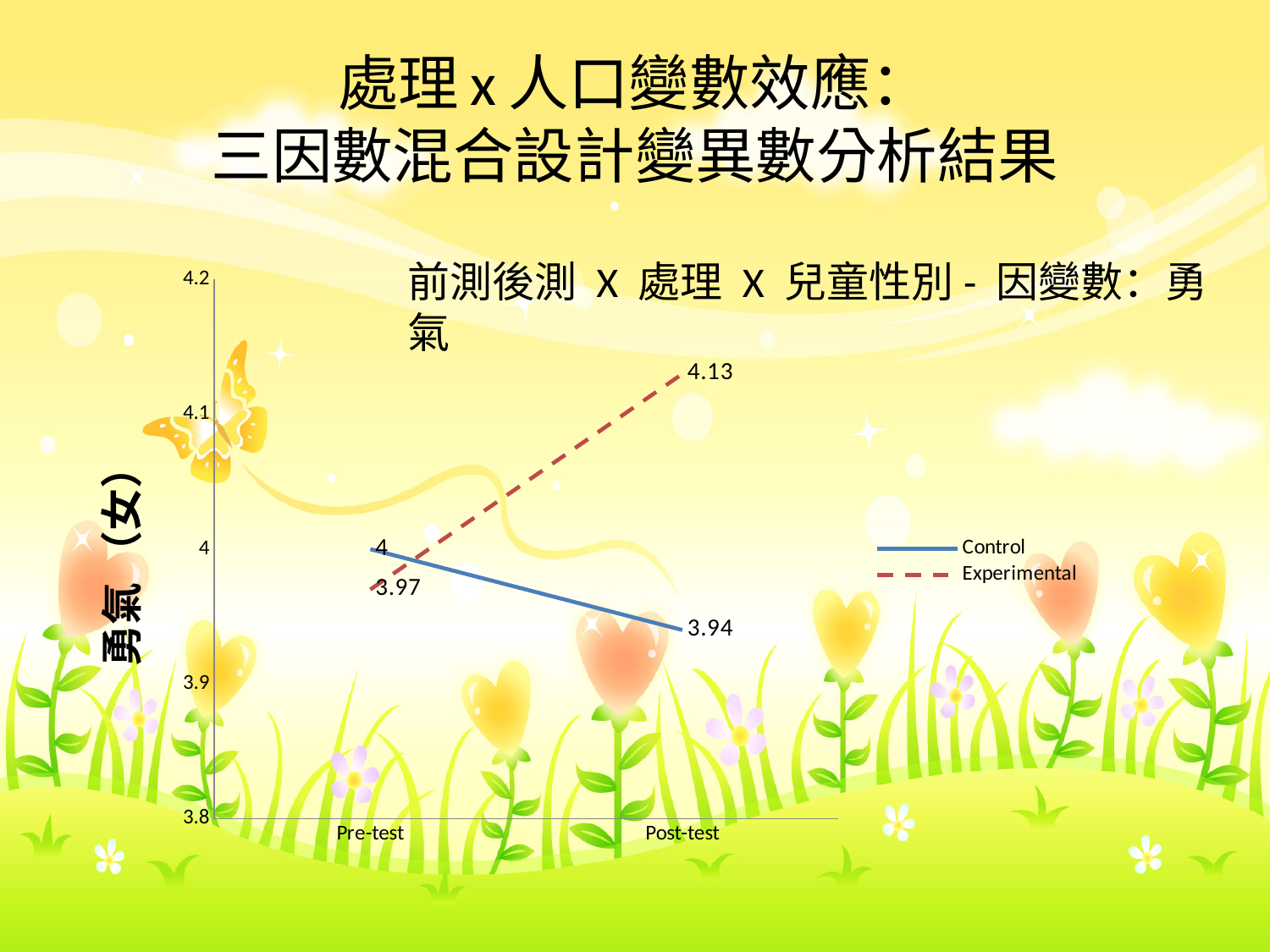
What is the Experimental value at Pre-test? 3.97 What is the difference between the Experimental and Control values at Post-test? 0.19 Does the Control line rise or fall from Pre-test to Post-test? fall What is the Experimental value at Post-test? 4.13 Does the Experimental line rise or fall from Pre-test to Post-test? rise By how much does the Experimental value change from Pre-test to Post-test? 0.16 How many series does the legend list? 2 Which series has the higher value at Post-test? Experimental Which series is drawn with a dashed line? Experimental What is the Control value at Post-test? 3.94 What kind of chart is shown on the slide? line chart What is the Control value at Pre-test? 4